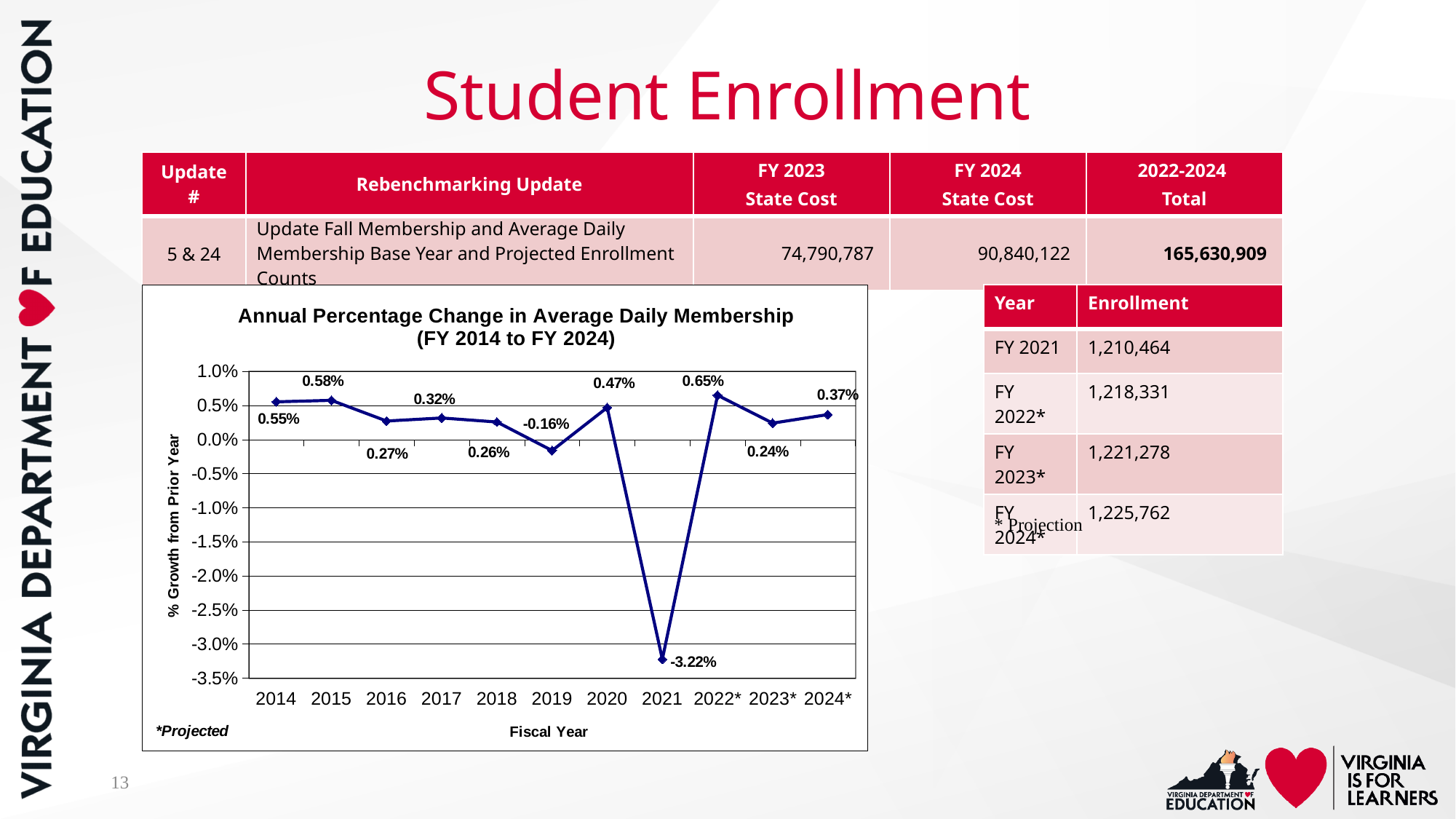
Which fiscal year has the highest annual percentage change in average daily membership? 2022* What is the annual percentage change in average daily membership for fiscal year 2021? -3.22% Is the value for 2021 greater or less than -3.0%? less What is the title of the chart? Annual Percentage Change in Average Daily Membership (FY 2014 to FY 2024) What is the annual percentage change in average daily membership for fiscal year 2014? 0.55% What is the difference in percentage points between the 2022* value (0.65%) and the 2023* value (0.24%)? 0.41 percentage points Which fiscal year has the lowest annual percentage change in average daily membership? 2021 What type of chart is shown on the slide? Line chart What is the projected annual percentage change in average daily membership for 2024*? 0.37% Which is larger, the percentage change for 2020 or for 2016? 2020 What is the annual percentage change in average daily membership for fiscal year 2019? -0.16% How many fiscal years are plotted on the x axis of the chart? 11